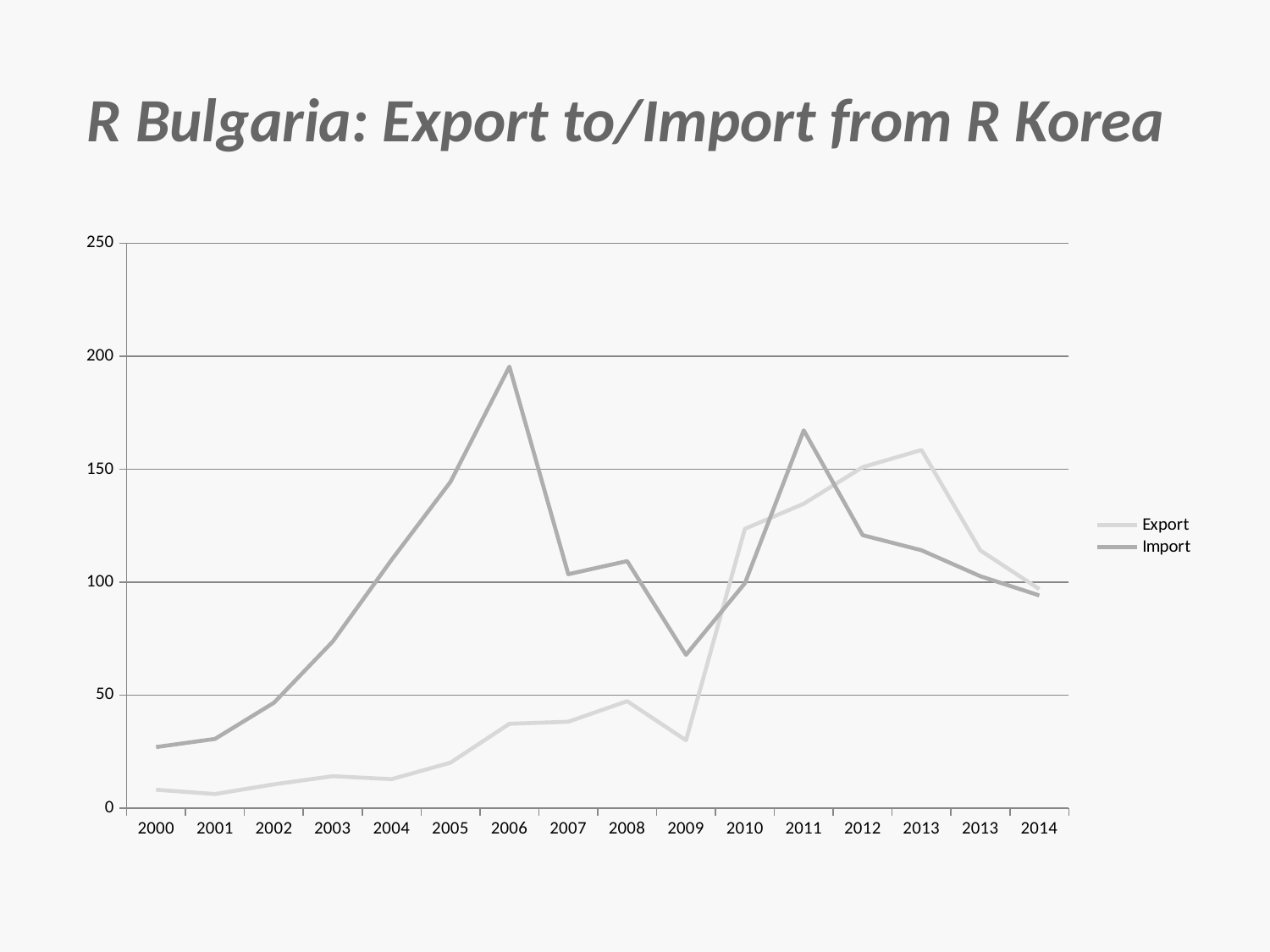
What kind of chart is shown on the slide? line chart In 2006, which series has the larger value, Export or Import? Import Is the Export value for 2009 greater or less than 50? less Is the Import value for 2006 greater or less than 150? greater Is the Export value for 2012 greater or less than 100? greater In 2012, which series has the larger value, Export or Import? Export In which year does the Export series reach its highest value? 2013 Does the Import series rise or fall from 2011 to 2014? fall What are the two series named in the legend? Export and Import In which year does the Import series reach its highest value? 2006 How many series does the legend list? 2